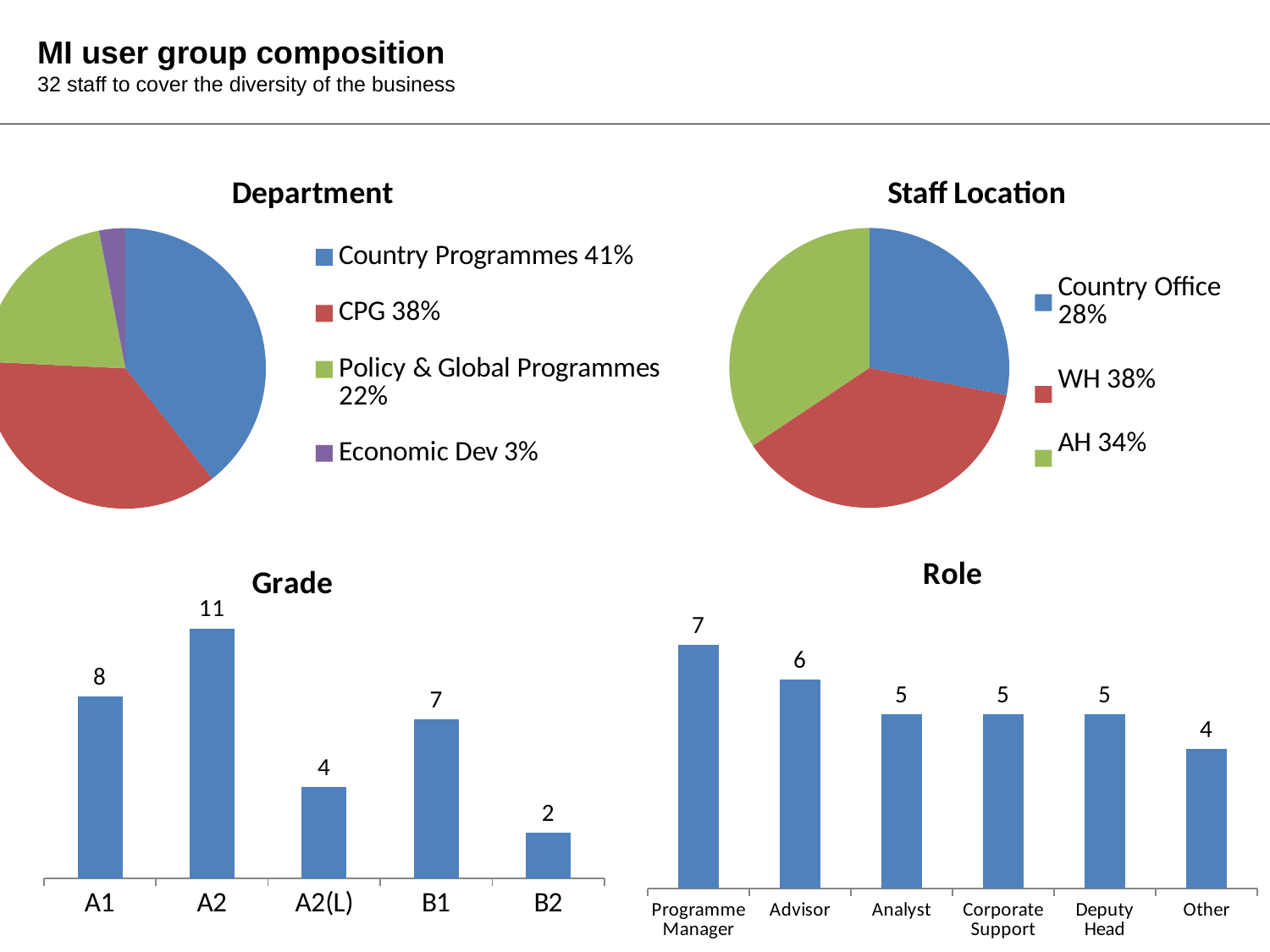
In the Staff Location pie chart, what share is WH? 38% In the Grade chart, what is the difference between A1 and B1? 1 In the Department pie chart, what share does CPG have? 38% In the Staff Location pie chart, which location has the smallest share? Country Office In the Department pie chart, which department has the largest share? Country Programmes In the Grade chart, which grade has the lowest value? B2 In the Grade chart, what is the value for A2? 11 In the Staff Location pie chart, how many locations are shown? 3 In the Role chart, what is the value for Advisor? 6 In the Department pie chart, which department has the smallest share? Economic Dev In the Role chart, which role has the highest value? Programme Manager What kind of chart is the Role chart? Bar chart